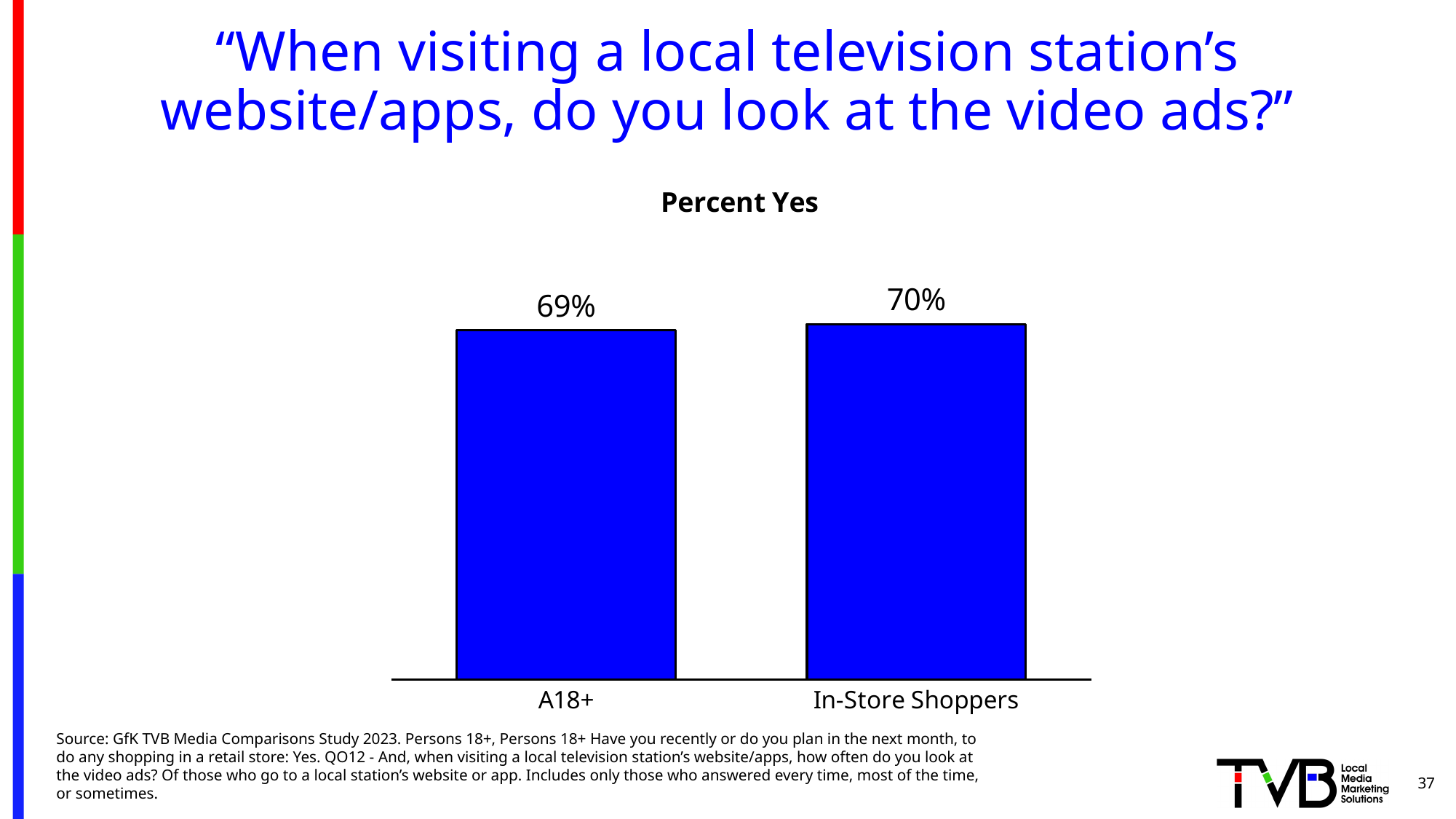
Is the Percent Yes value for In-Store Shoppers larger or smaller than the value for A18+? larger What is the difference between the Percent Yes values for In-Store Shoppers and A18+? 1% What is the Percent Yes value for A18+? 69% What is the title of the chart? Percent Yes Which category has the lower Percent Yes value? A18+ Which category has the higher Percent Yes value? In-Store Shoppers What is the Percent Yes value for In-Store Shoppers? 70% What colour are the bars in the chart? blue How many categories are shown in the chart? 2 What kind of chart is shown on the slide? bar chart